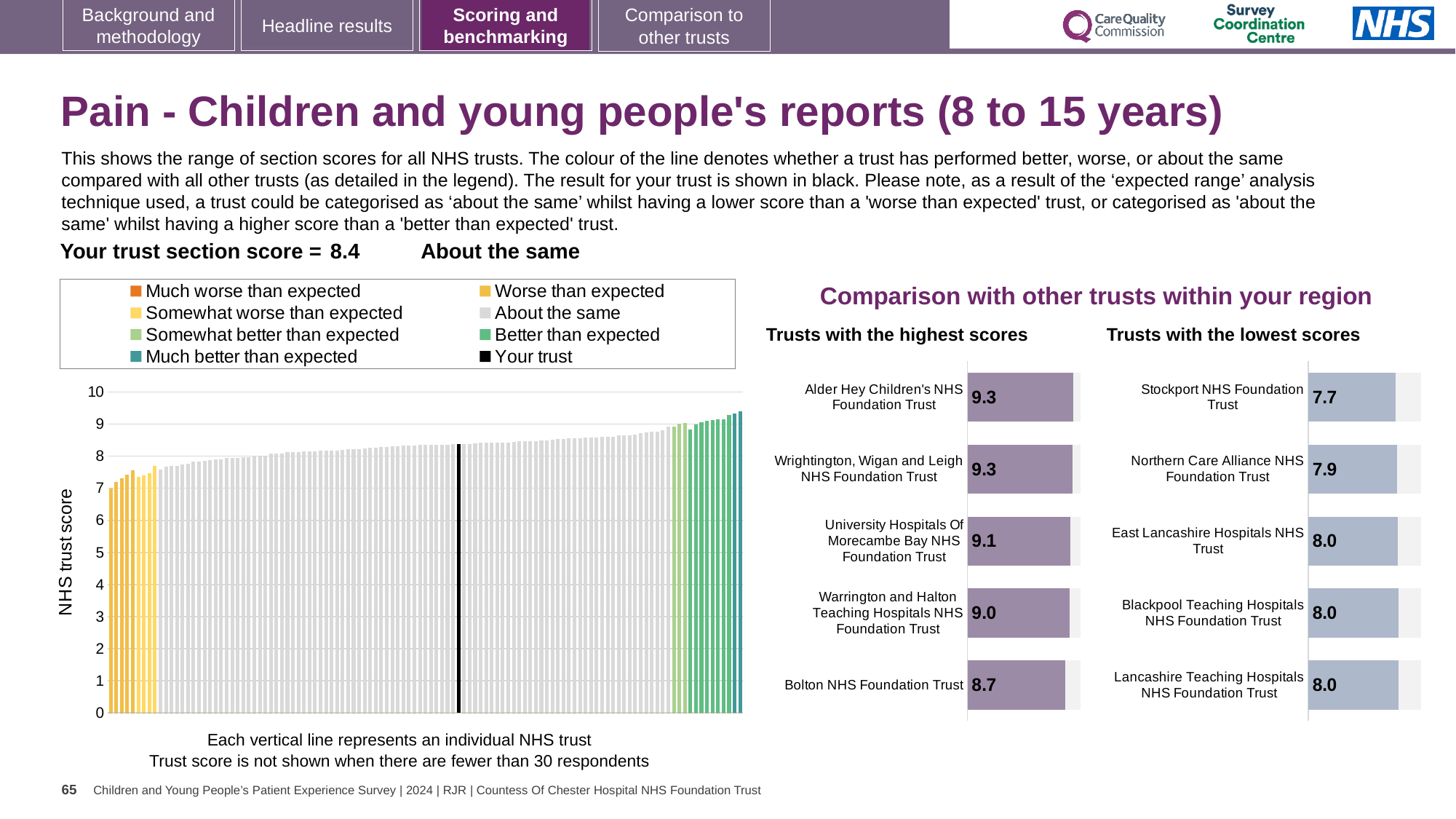
In the 'Trusts with the lowest scores' chart, which trust has the lowest score? Stockport NHS Foundation Trust What kind of chart is the large chart on the left with the y axis labelled 'NHS trust score'? bar chart In the 'Trusts with the highest scores' chart, what is the difference between the score for Alder Hey Children's NHS Foundation Trust and the score for Bolton NHS Foundation Trust? 0.6 In the large chart on the left, is the value of the leftmost (lowest) bar greater or less than 6? greater How many trusts are shown in the 'Trusts with the lowest scores' chart? 5 How many entries does the legend above the large chart on the left list? 8 In the 'Trusts with the highest scores' chart, what is the score for University Hospitals Of Morecambe Bay NHS Foundation Trust? 9.1 In the large chart on the left, is the value of the rightmost (highest) bar greater or less than 10? less In the 'Trusts with the highest scores' chart, which trust has the lowest score? Bolton NHS Foundation Trust In the large chart on the left, do the bars rise or fall from left to right? rise In the 'Trusts with the lowest scores' chart, which has the larger score: Stockport NHS Foundation Trust or Northern Care Alliance NHS Foundation Trust? Northern Care Alliance NHS Foundation Trust In the 'Trusts with the highest scores' chart, what is the score for Bolton NHS Foundation Trust? 8.7